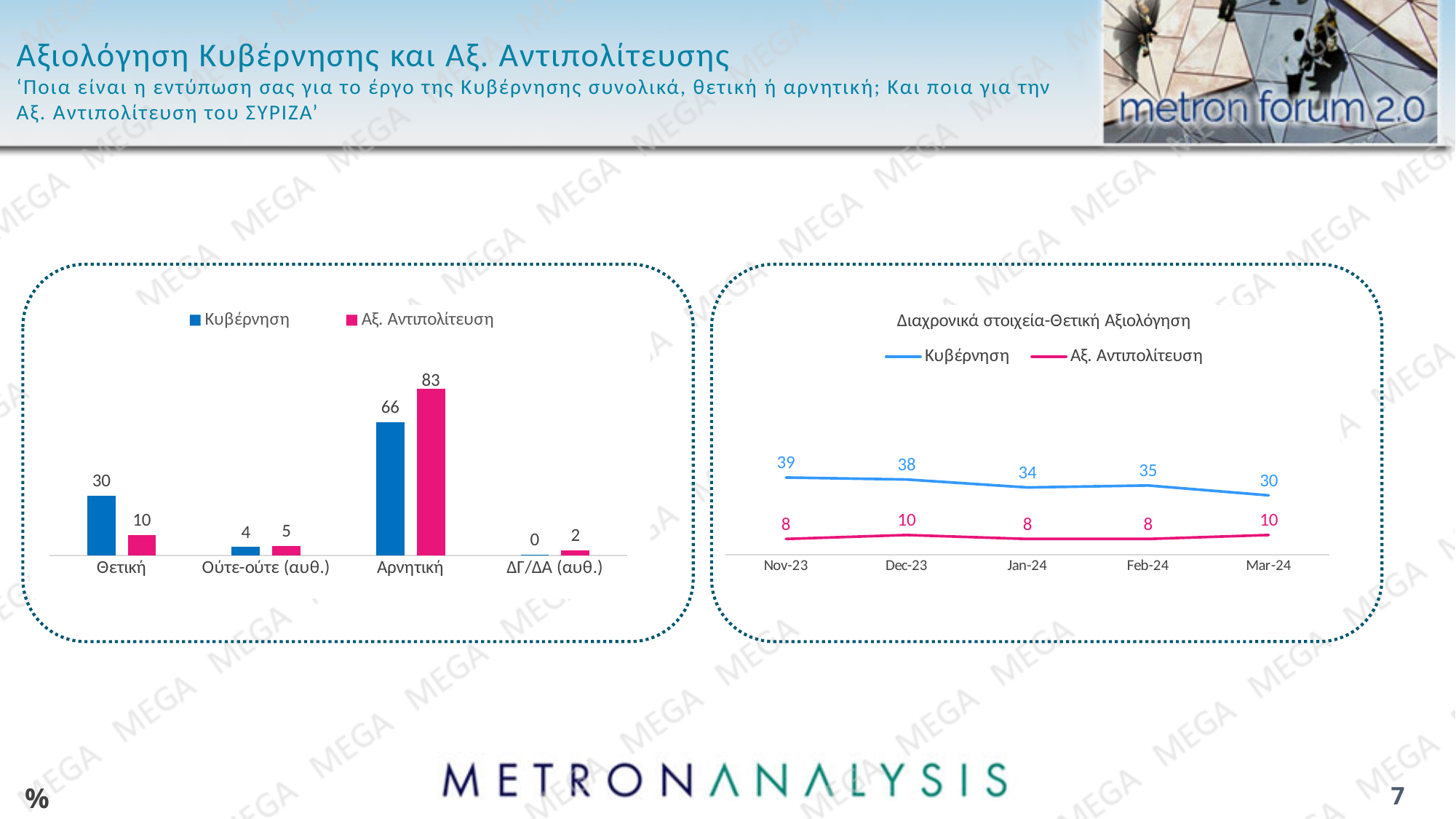
In the chart titled 'Διαχρονικά στοιχεία-Θετική Αξιολόγηση', in which month is the Κυβέρνηση value lowest? Mar-24 In the chart titled 'Διαχρονικά στοιχεία-Θετική Αξιολόγηση', what is the value for Κυβέρνηση in Jan-24? 34 In the bar chart on the left, which category has the highest value for Κυβέρνηση? Αρνητική In the bar chart on the left, what is the difference between the Αξ. Αντιπολίτευση and Κυβέρνηση values in the Αρνητική category? 17 What type of chart is the chart on the left of the slide? Bar chart How many categories are shown on the x axis of the bar chart on the left? 4 In the chart titled 'Διαχρονικά στοιχεία-Θετική Αξιολόγηση', what is the value for Αξ. Αντιπολίτευση in Mar-24? 10 In the bar chart on the left, what is the value for Αξ. Αντιπολίτευση in the Αρνητική category? 83 In the bar chart on the left, which series has the larger value in the Θετική category, Κυβέρνηση or Αξ. Αντιπολίτευση? Κυβέρνηση How many series does the legend of the chart titled 'Διαχρονικά στοιχεία-Θετική Αξιολόγηση' list? 2 In the chart titled 'Διαχρονικά στοιχεία-Θετική Αξιολόγηση', does the Κυβέρνηση line generally rise or fall from Nov-23 to Mar-24? Fall In the bar chart on the left, what is the value for Κυβέρνηση in the Θετική category? 30